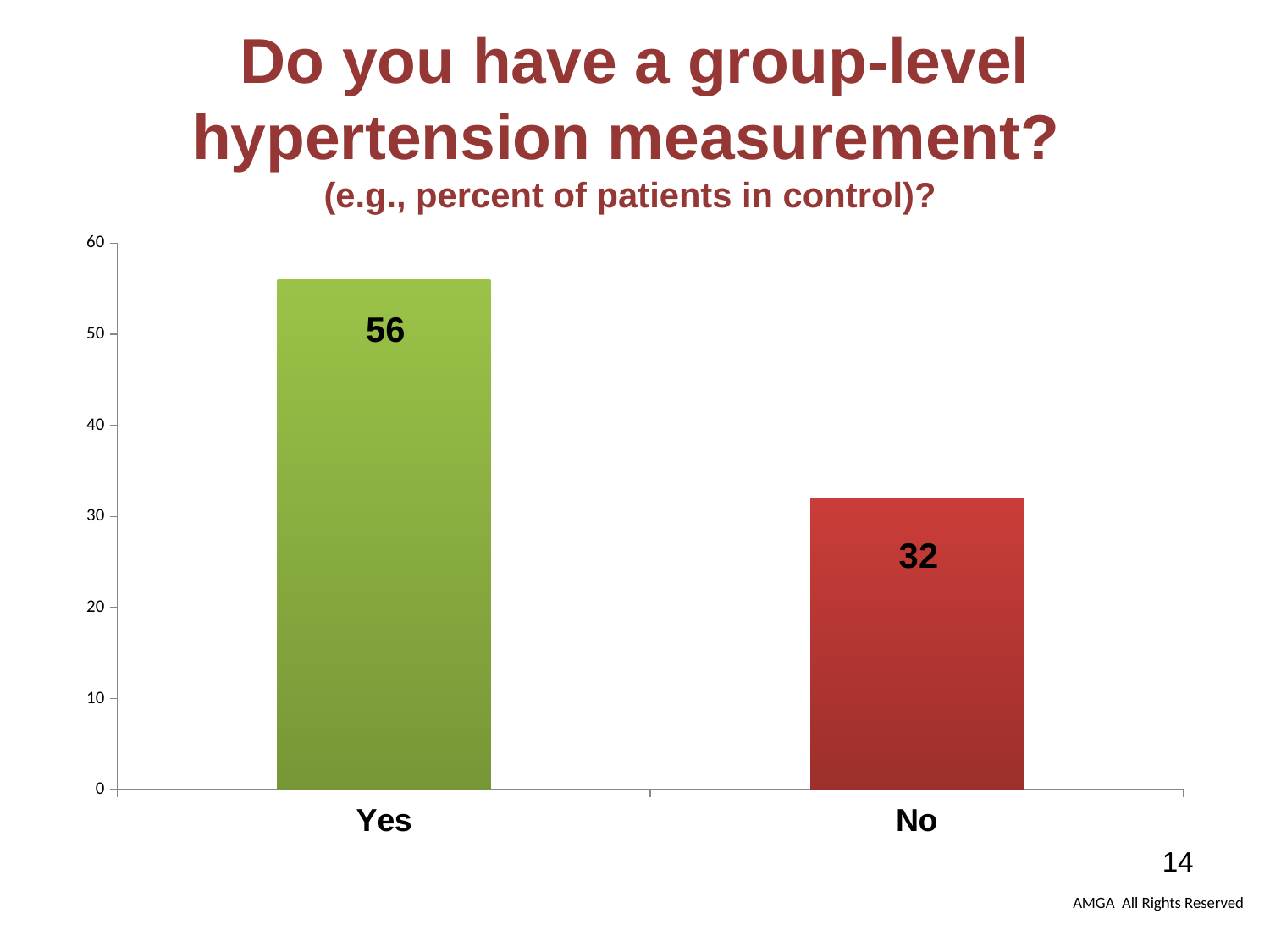
What is the value for No? 32 How many categories are shown on the x axis? 2 What colour is the bar for No? red What kind of chart is shown on the slide? bar chart What is the difference between the values for Yes and No? 24 What is the value for Yes? 56 Which category has the lowest value? No Is the value for Yes greater or less than 50? greater Which category has the highest value? Yes What is the total of the values for Yes and No? 88 Which is larger, the value for Yes or the value for No? Yes Is the value for No greater or less than 40? less